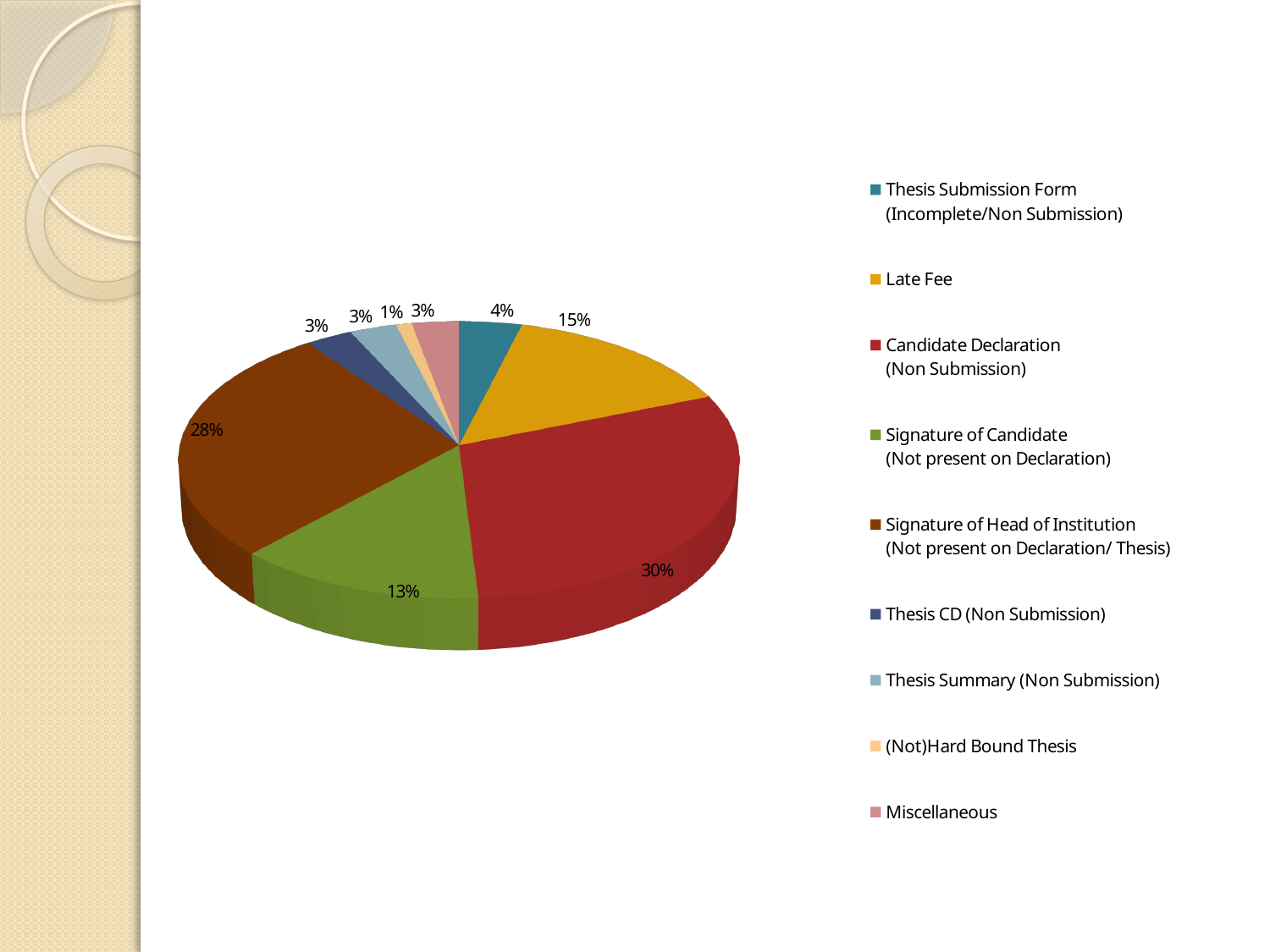
Which is larger, the slice for Late Fee or the slice for Signature of Candidate (Not present on Declaration)? Late Fee What share of the pie does Late Fee represent? 15% Which category has the largest slice of the pie? Candidate Declaration (Non Submission) What kind of chart is shown on the slide? pie chart What is the difference in percentage points between Candidate Declaration (Non Submission) and Signature of Head of Institution (Not present on Declaration/ Thesis)? 2% What share of the pie does Signature of Candidate (Not present on Declaration) represent? 13% What colour is the slice for Miscellaneous? pink How many categories does the legend list? 9 Which category has the smallest slice of the pie? (Not)Hard Bound Thesis What share of the pie does Candidate Declaration (Non Submission) represent? 30%